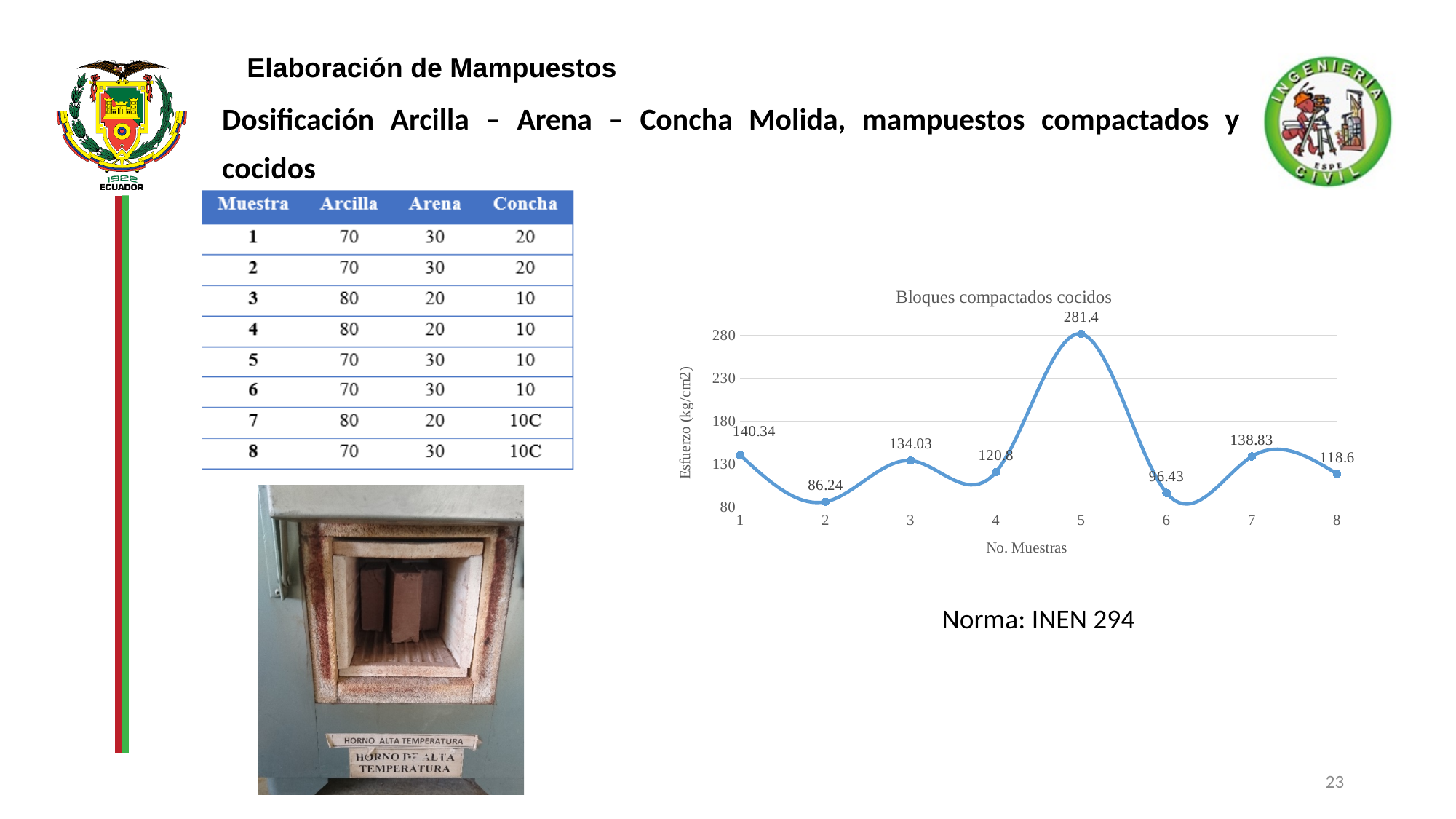
What is the Esfuerzo value for sample 5? 281.4 What type of chart is shown on the slide? line chart What is the title of the chart? Bloques compactados cocidos Is the value for sample 6 greater or less than 130? less Which sample number has the highest Esfuerzo value? 5 What is the Esfuerzo value for sample 2? 86.24 Which has a larger Esfuerzo value, sample 3 or sample 4? sample 3 What is the difference between the Esfuerzo values of sample 5 and sample 1? 141.06 How many samples are plotted on the chart? 8 Which sample number has the lowest Esfuerzo value? 2 What is the Esfuerzo value for sample 7? 138.83 What is the label of the vertical axis of the chart? Esfuerzo (kg/cm2)